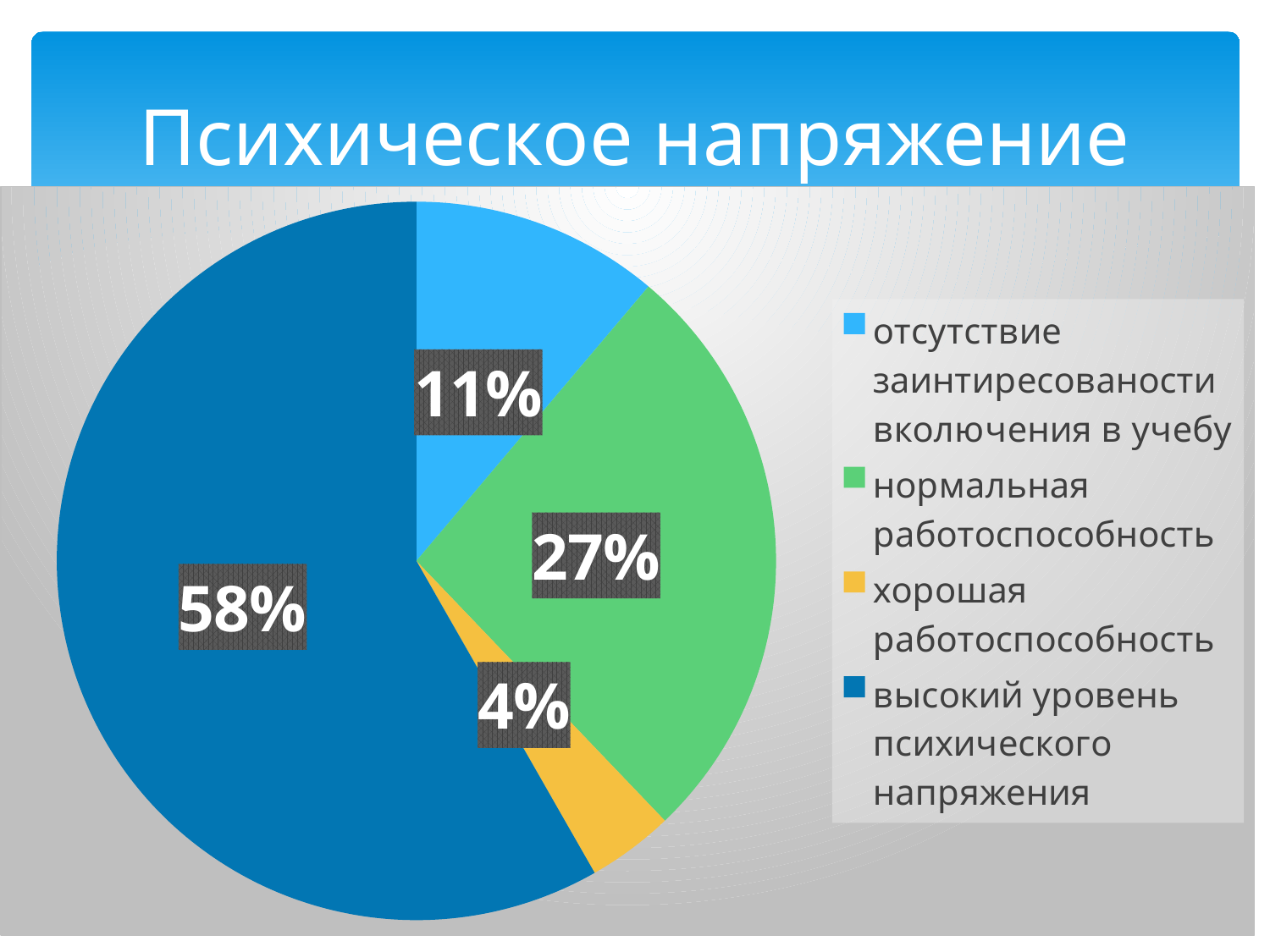
Which category has the largest slice of the pie? высокий уровень психического напряжения What is the share for "нормальная работоспособность"? 27% What colour is the slice for "нормальная работоспособность"? green What is the share for "хорошая работоспособность"? 4% What is the title of the slide? Психическое напряжение What is the share for "высокий уровень психического напряжения"? 58% Which is larger: the share for "отсутствие заинтиресованости воключения в учебу" or the share for "хорошая работоспособность"? отсутствие заинтиресованости воключения в учебу Which category has the smallest slice of the pie? хорошая работоспособность How many slices does the pie chart have? 4 What is the share for "отсутствие заинтиресованости воключения в учебу"? 11% What kind of chart is shown on the slide? pie chart What is the difference in percentage points between "высокий уровень психического напряжения" and "нормальная работоспособность"? 31